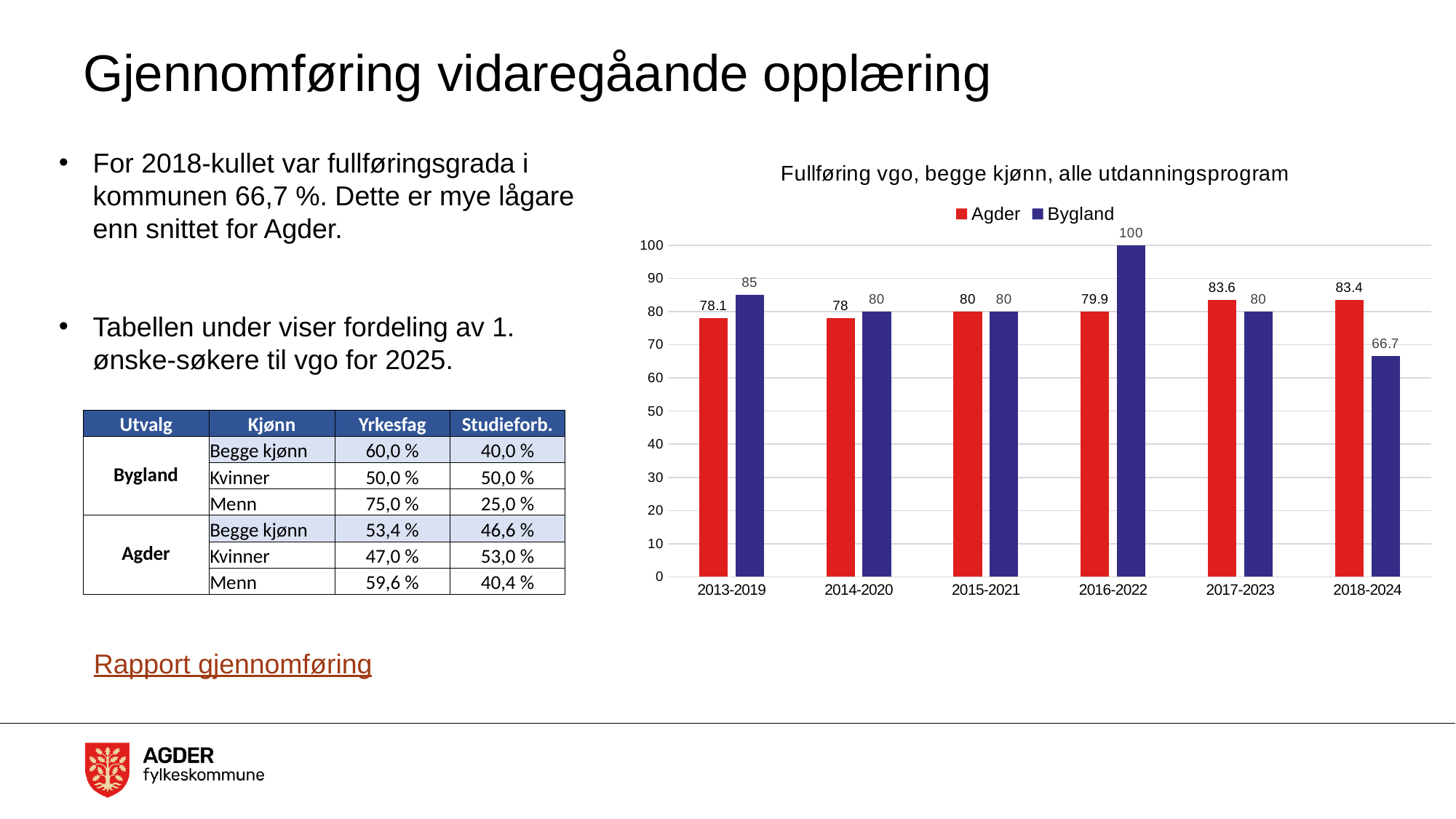
What is the value for Bygland in 2016-2022? 100 How many series does the legend list? 2 What is the value for Bygland in 2018-2024? 66.7 In which period is the Bygland value lowest? 2018-2024 What is the value for Agder in 2013-2019? 78.1 Which is larger in 2013-2019, Agder or Bygland? Bygland What is the difference between the Bygland and Agder values in 2018-2024? 16.7 How many periods are shown on the x axis? 6 What is the value for Agder in 2017-2023? 83.6 What kind of chart is shown? Bar chart In which period is the Bygland value highest? 2016-2022 What is the title of the chart? Fullføring vgo, begge kjønn, alle utdanningsprogram